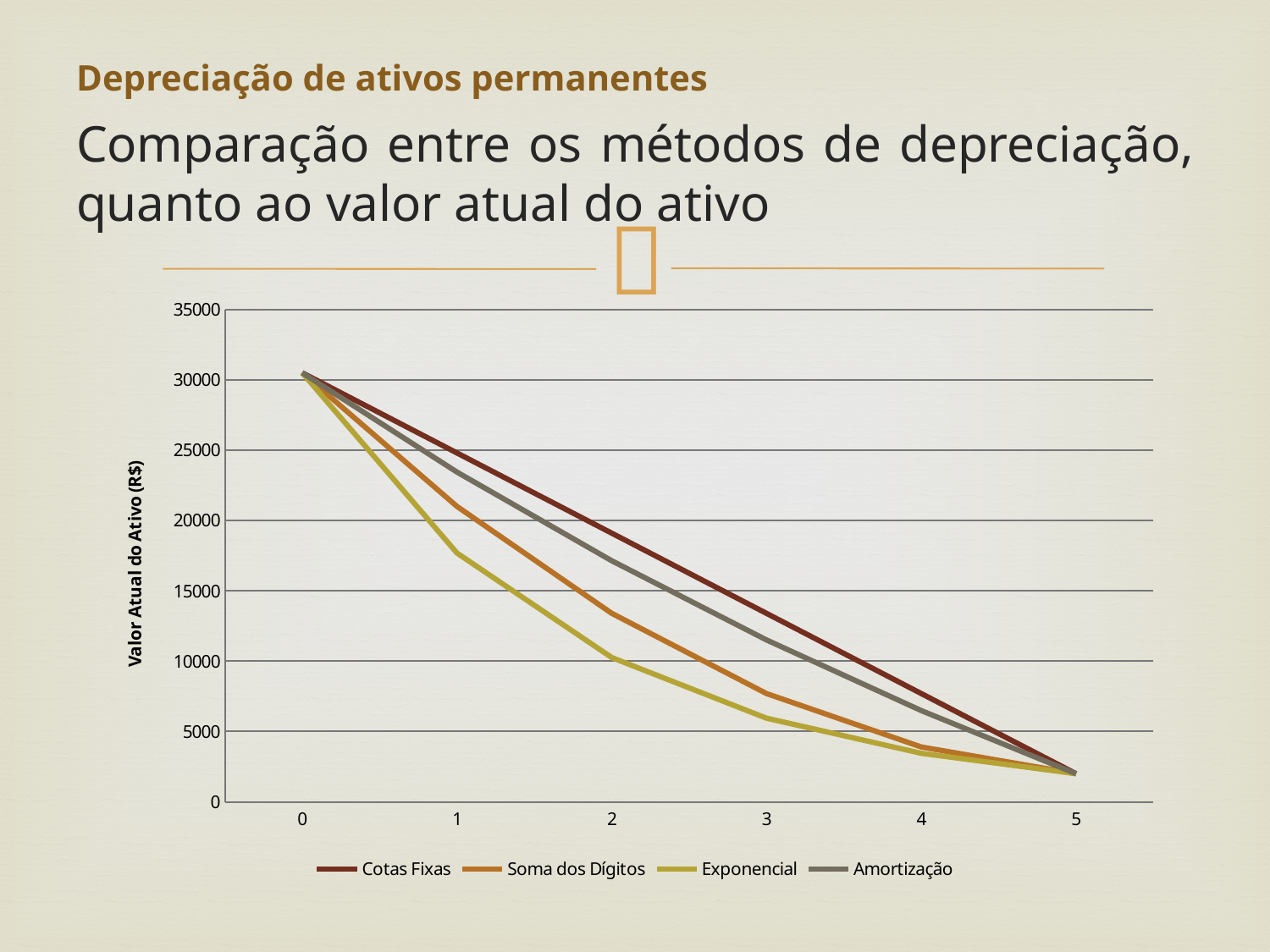
Is the value for Exponencial at x = 1 greater or less than 20000? less Is the value for Amortização at x = 4 greater or less than 10000? less Which series has the highest value at x = 1? Cotas Fixas Which series has the lowest value at x = 2? Exponencial At x = 2, which is larger: Amortização or Exponencial? Amortização At x = 1, which is larger: Cotas Fixas or Exponencial? Cotas Fixas How many points along the x axis does each line have? 6 Do the values of the Exponencial series rise or fall along the x axis? fall What kind of chart is shown on the slide? line chart Is the value for Soma dos Dígitos at x = 2 greater or less than 15000? less What is the title of the vertical axis? Valor Atual do Ativo (R$) How many series does the legend list? 4